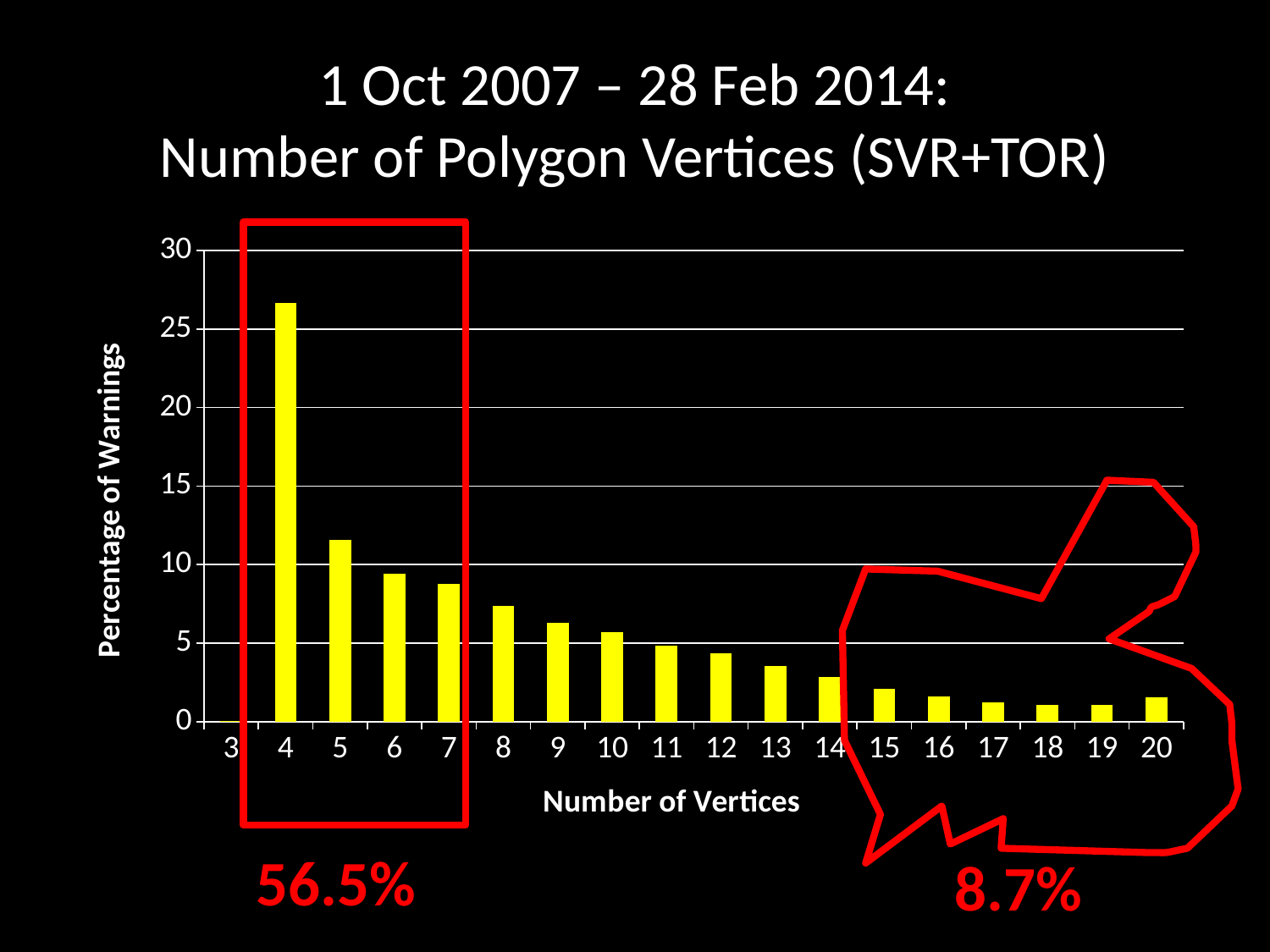
Is the value for 5 vertices greater or less than 10? greater Is the value for 7 vertices greater or less than 10? less Is the value for 12 vertices greater or less than 5? less Which number of vertices has the lowest percentage of warnings? 3 Which number of vertices has the highest percentage of warnings? 4 What percentage is annotated in red for the boxed group of 4 to 7 vertices? 56.5% What kind of chart is shown on the slide? bar chart What percentage is annotated in red for the circled group of 15 to 20 vertices? 8.7% From 4 vertices to 20 vertices, do the bar values generally rise or fall? fall Which has a higher percentage of warnings, 5 vertices or 6 vertices? 5 vertices How many vertex-count categories are shown on the x axis? 18